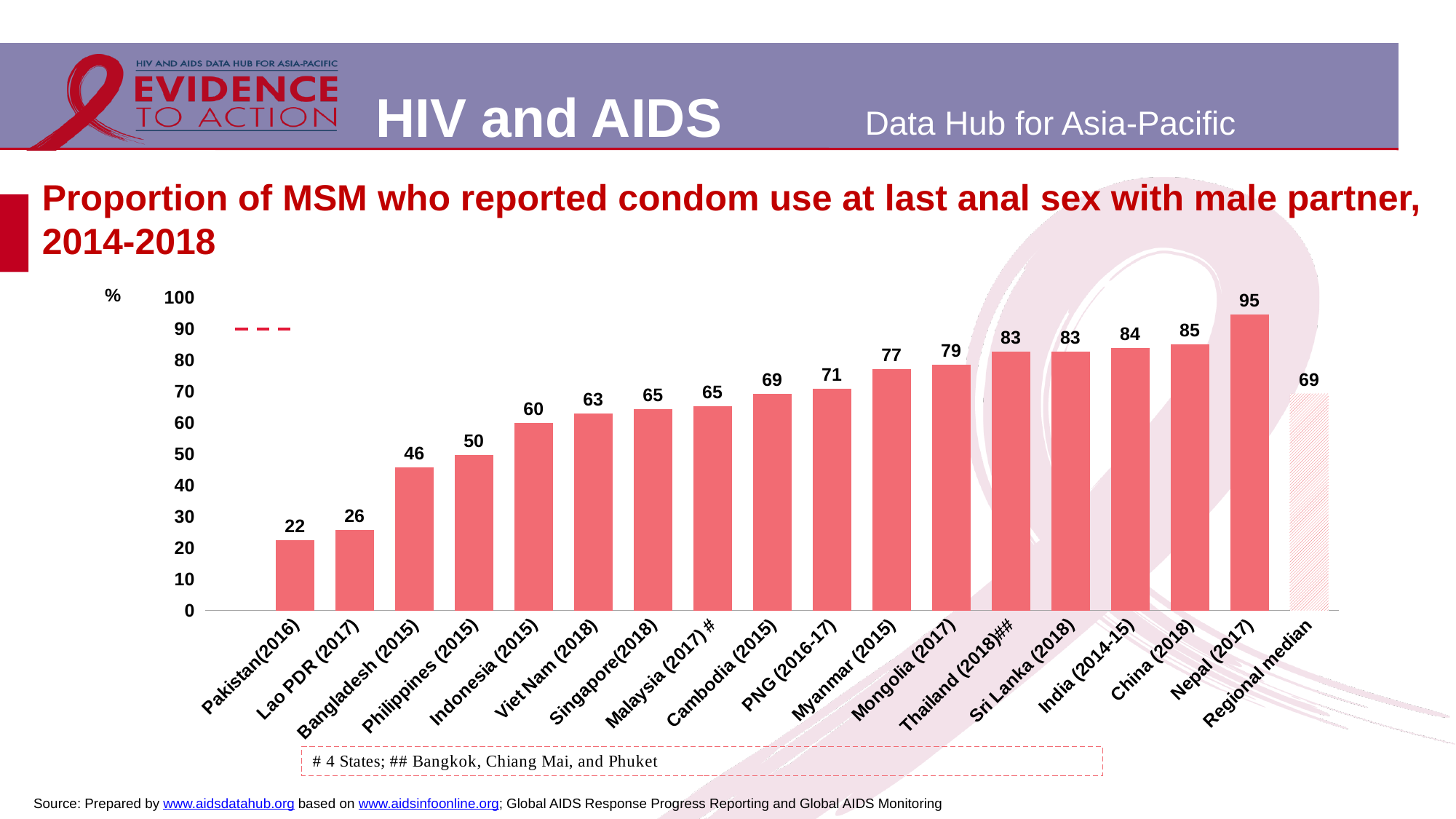
What is the value for Pakistan (2016)? 22 Is the value for Bangladesh (2015) greater or less than 50? less Which country has the lowest proportion of MSM reporting condom use at last anal sex? Pakistan (2016) Which country has the highest proportion of MSM reporting condom use at last anal sex? Nepal (2017) How many bars are plotted on the chart, including the Regional median? 18 Do the country values generally rise or fall from left to right along the x axis? Rise What is the value for Nepal (2017)? 95 What kind of chart is shown on the slide? Bar chart What is the difference between the values for China (2018) and Lao PDR (2017)? 59 What is the value for India (2014-15)? 84 What is the Regional median value shown on the chart? 69 Which is larger, the value for Myanmar (2015) or the value for Cambodia (2015)? Myanmar (2015)